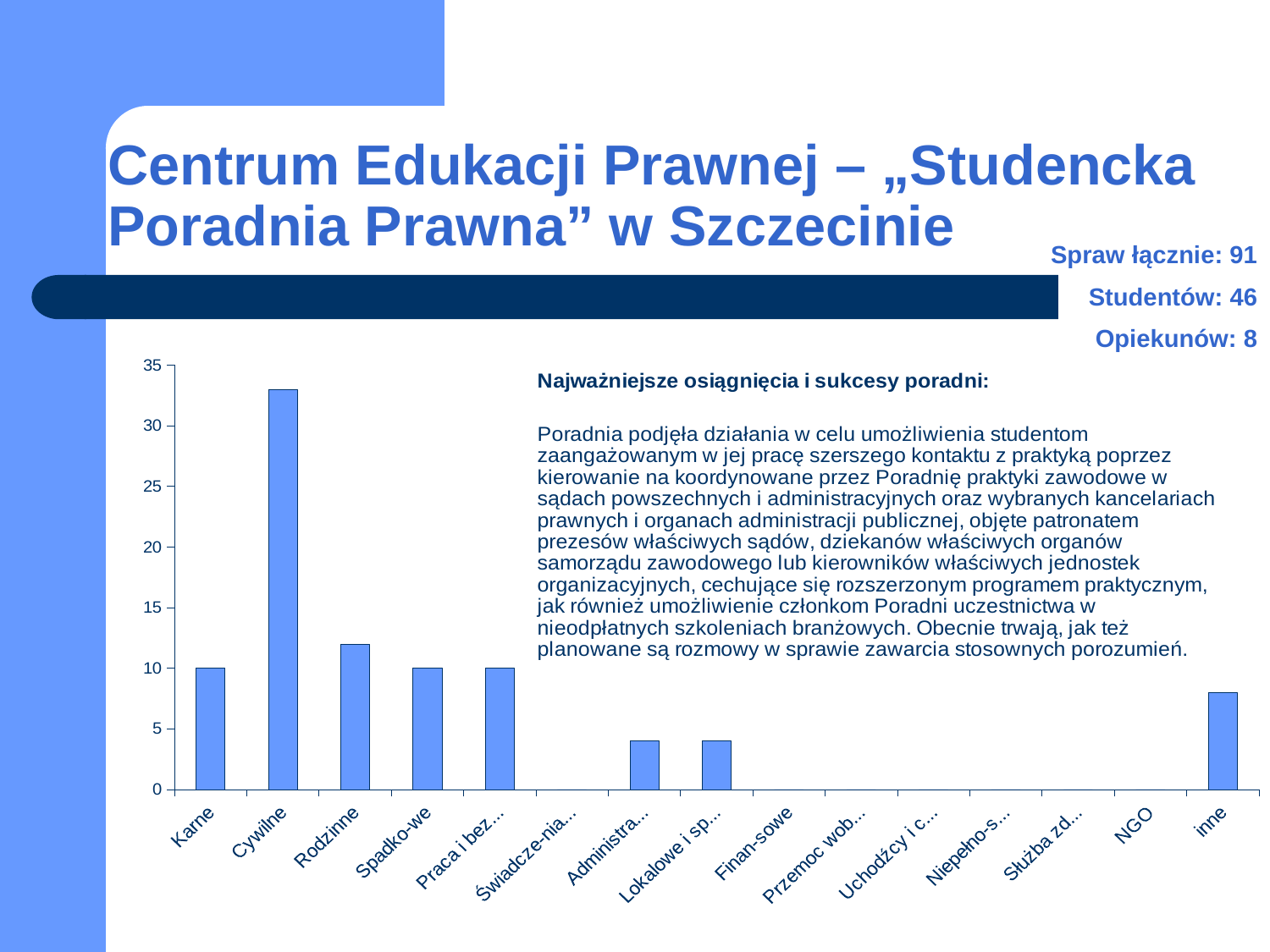
What kind of chart is shown on the slide? bar chart Which is larger, the value for Karne or the value for Administra...? Karne Is the value for inne greater or less than 10? less Is the value for Rodzinne greater or less than 10? greater Which is larger, the value for Cywilne or the value for Rodzinne? Cywilne Is the value for Administra... greater or less than 5? less Which is larger, the value for Rodzinne or the value for inne? Rodzinne Which category has the highest bar in the chart? Cywilne How many categories are shown on the x axis of the chart? 15 What is the value of the bar for Karne? 10